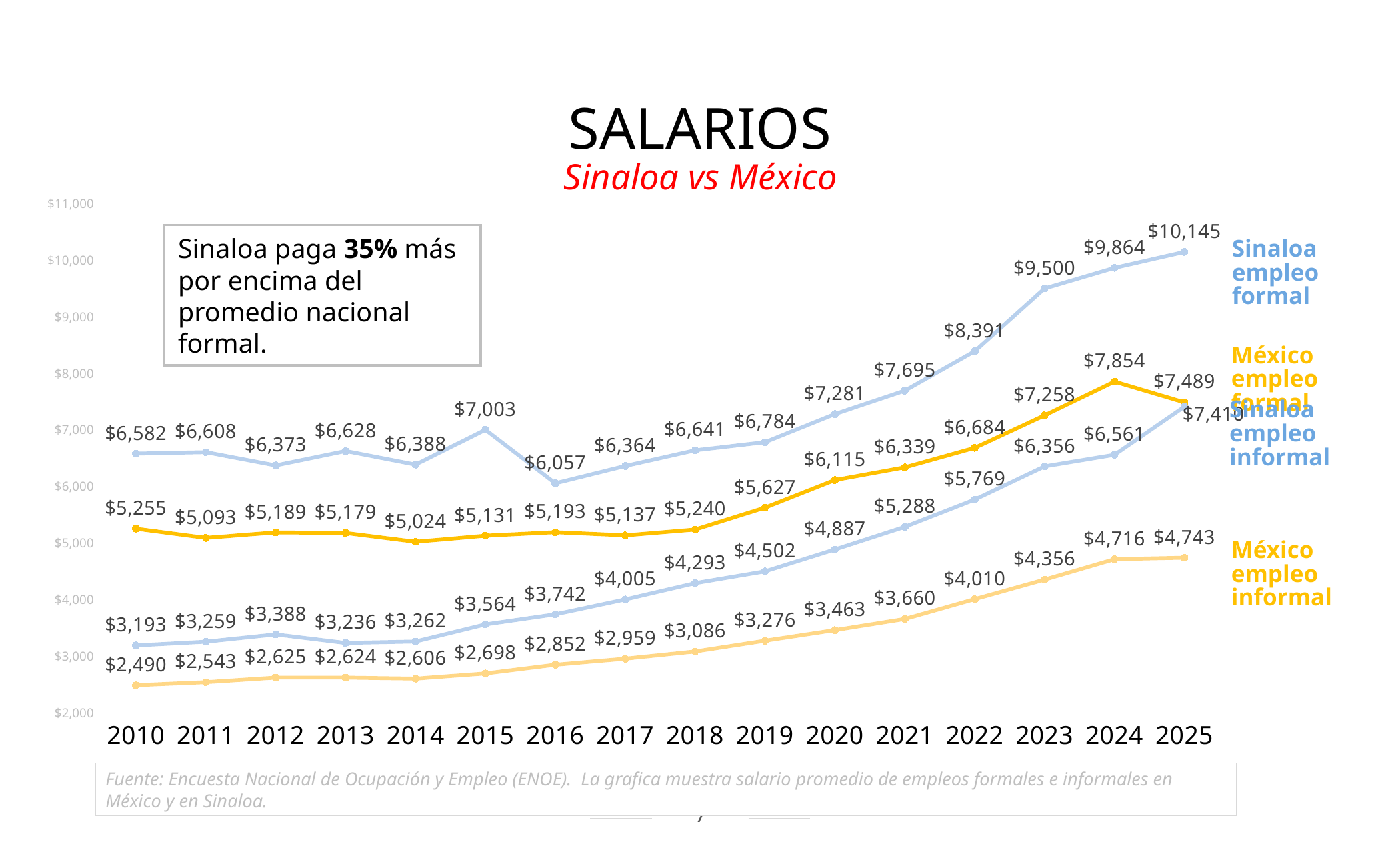
What is the value for Sinaloa empleo formal in 2025? $10,145 What is the value for México empleo informal in 2019? $3,276 In which year is the México empleo formal series at its highest? 2024 What is the value for México empleo formal in 2024? $7,854 In which year is the Sinaloa empleo formal series at its lowest? 2016 What is the value for Sinaloa empleo informal in 2010? $3,193 Which is larger in 2025: Sinaloa empleo informal or México empleo formal? México empleo formal Does the México empleo informal series rise or fall from 2010 to 2025? Rise How many years are shown on the x axis? 16 What is the difference between Sinaloa empleo formal and México empleo formal in 2025? $2,656 What kind of chart is shown on the slide? Line chart How many series does the chart show? 4